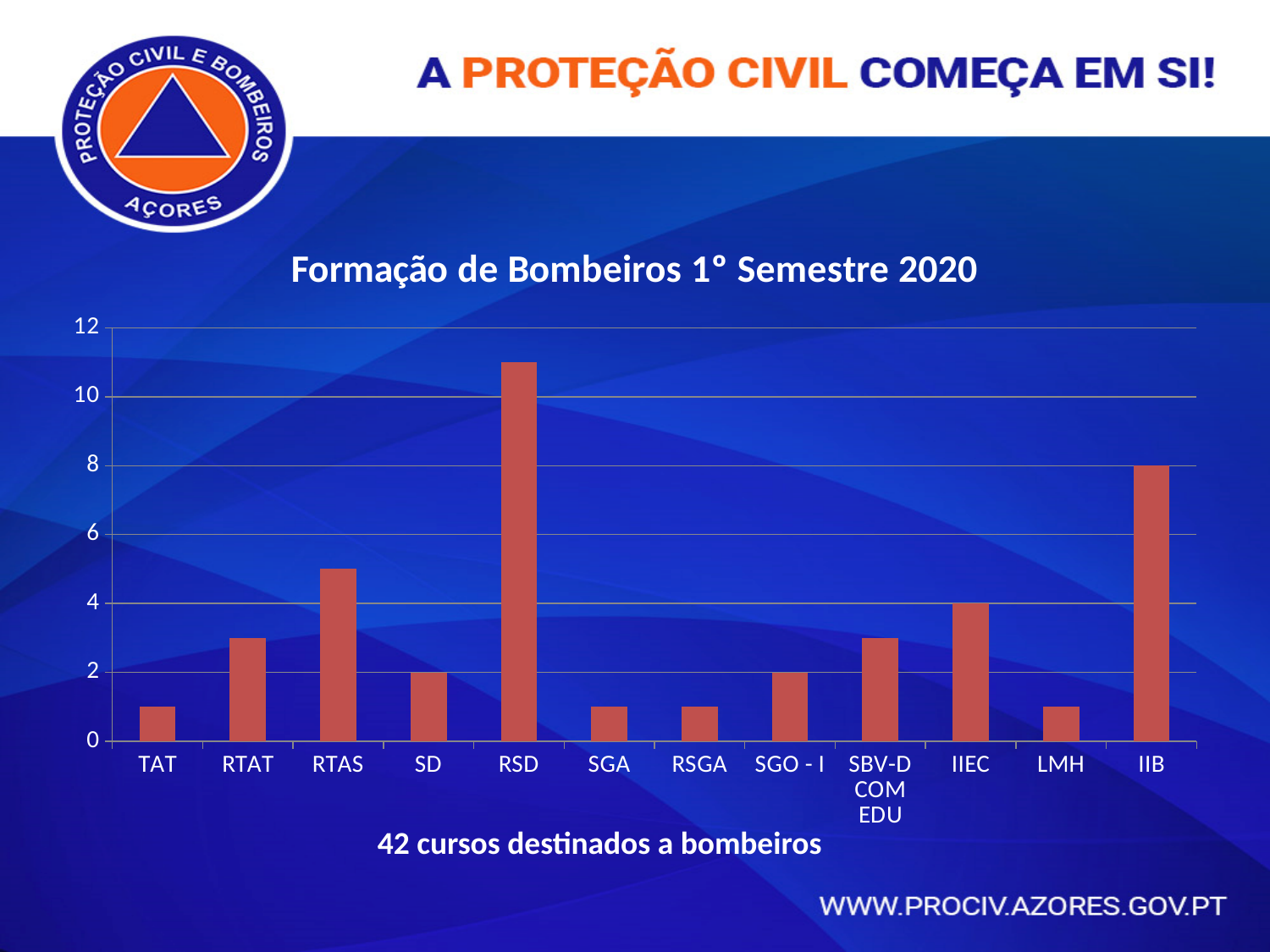
What is the value for SD? 2 Is the value for RSD greater or less than 10? greater What is the title of the chart? Formação de Bombeiros 1º Semestre 2020 Which category has the highest value in the chart? RSD Which is larger, the value for RTAS or the value for RTAT? RTAS What is the value for IIEC? 4 What kind of chart is shown on the slide? bar chart Is the value for TAT greater or less than 2? less How many categories are shown on the x axis of the chart? 12 What is the value for IIB? 8 What is the difference between the values for IIB and IIEC? 4 Is the value for RTAS greater or less than 4? greater